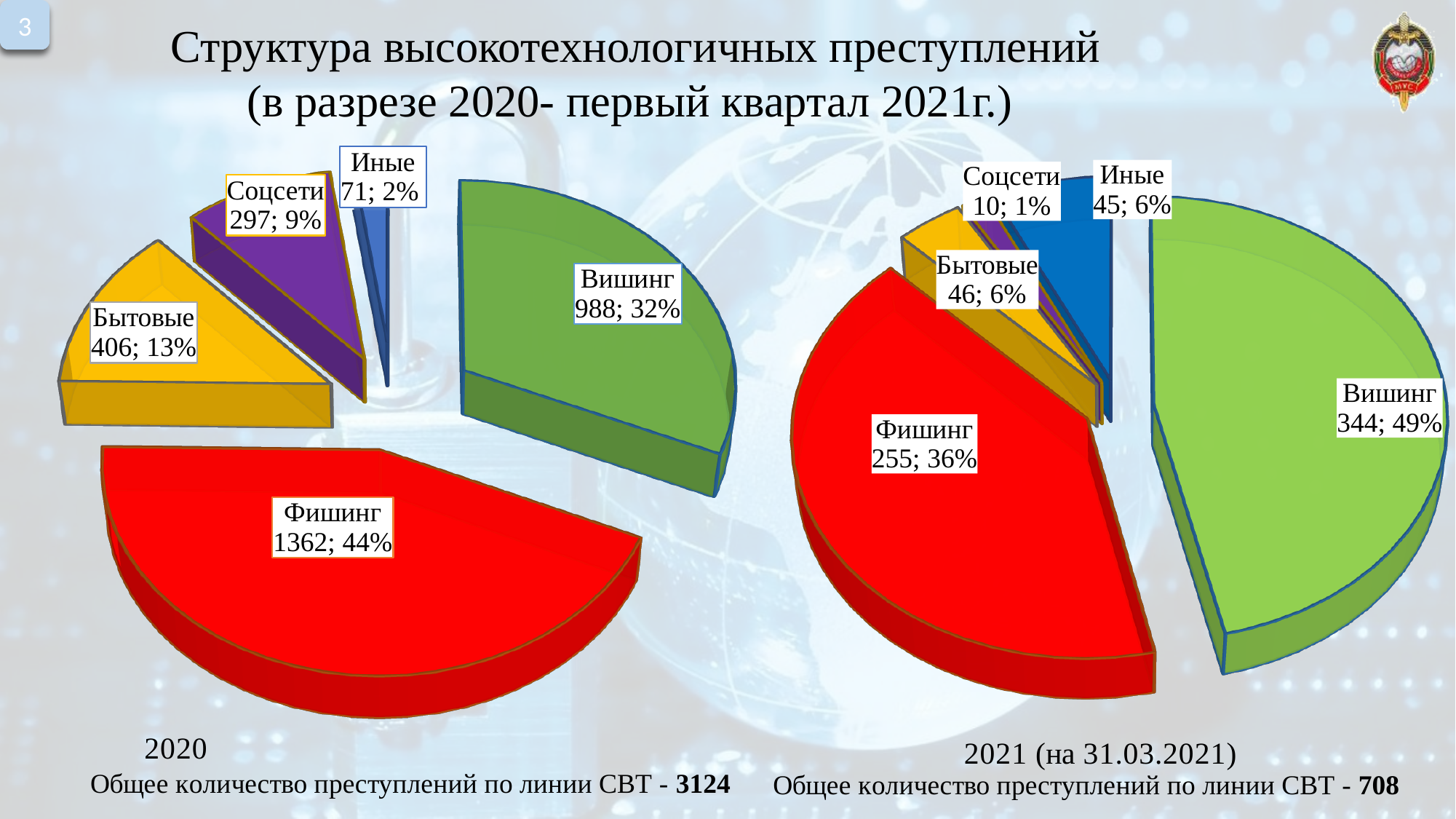
What colour is the Фишинг slice in both pie charts? Red In the 2020 pie chart (left), which category has the largest slice? Фишинг In the 2020 pie chart (left), what is the value for Фишинг? 1362; 44% What type of chart is used on the right side of the slide for 2021? Pie chart In the 2020 pie chart (left), what share of the pie does Бытовые take? 13% In the 2020 pie chart (left), what is the difference between the Бытовые and Соцсети counts? 109 In the 2021 pie chart (right), what is the value for Вишинг? 344; 49% In the 2020 pie chart (left), what is the difference between the Фишинг and Вишинг counts? 374 How many categories does the 2020 pie chart (left) show? 5 In the 2021 pie chart (right), which category has the smallest slice? Соцсети In the 2021 pie chart (right), which is larger, Вишинг or Фишинг? Вишинг In the 2021 pie chart (right), what is the value for Соцсети? 10; 1%